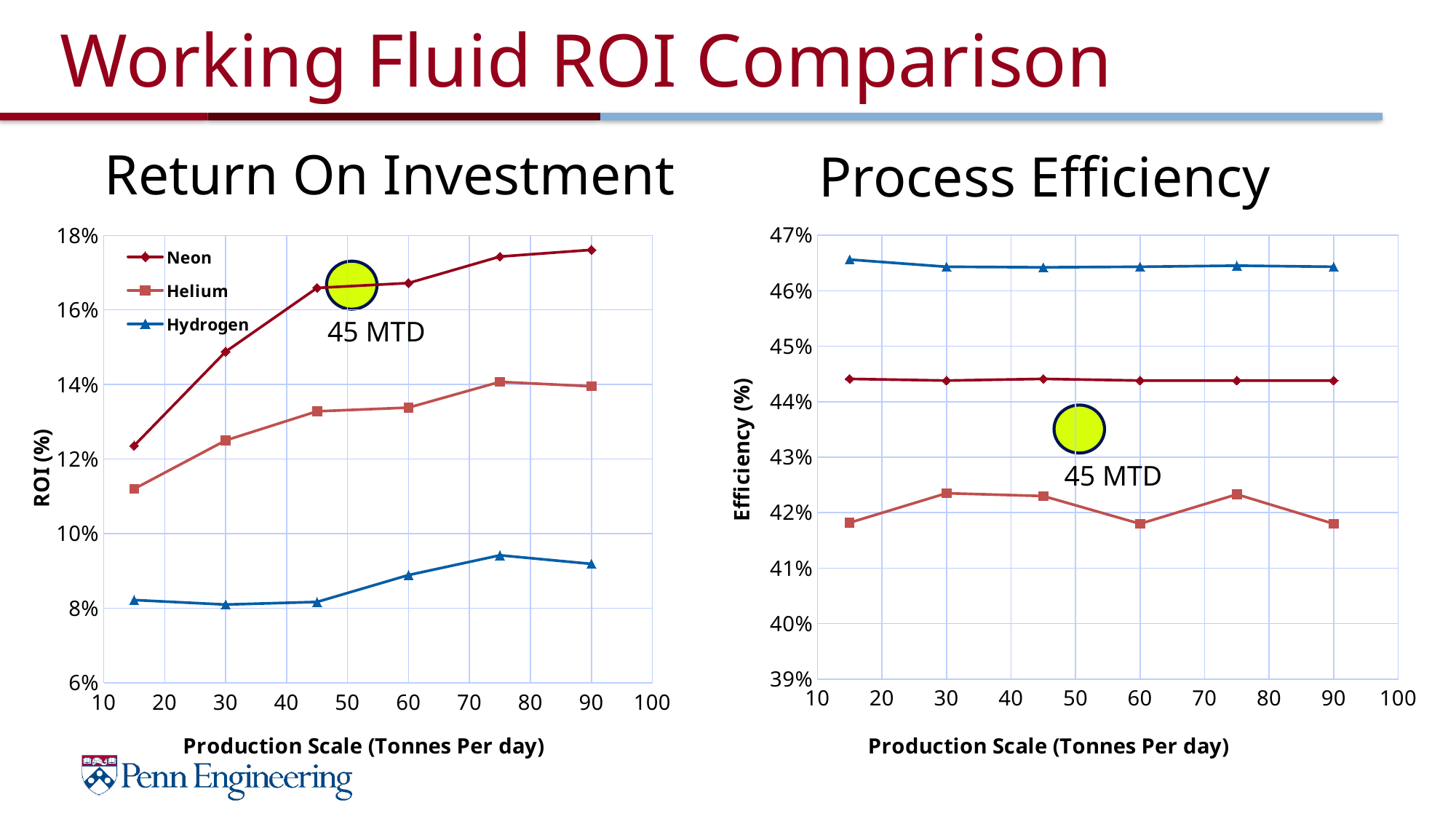
How many series does the legend of the Return On Investment chart list? 3 What kind of chart is the Return On Investment chart? line chart In the Return On Investment chart, which series has the highest ROI across the production scales shown? Neon In the Process Efficiency chart, is the efficiency of the blue triangle-marked line at a production scale of 15 greater or less than 46%? greater In the Process Efficiency chart, is the efficiency of the light red square-marked line at a production scale of 60 greater or less than 43%? less In the Return On Investment chart, does the Neon ROI rise or fall as production scale increases from 15 to 90? rise In the Return On Investment chart, which series has the lowest ROI across the production scales shown? Hydrogen In the Return On Investment chart, is the ROI for Hydrogen at a production scale of 15 greater or less than 10%? less What production scale is highlighted with a yellow circle and labelled on both charts? 45 MTD How many data points are plotted for each series in the Return On Investment chart? 6 In the Return On Investment chart, which is larger at a production scale of 60: the ROI for Helium or for Hydrogen? Helium